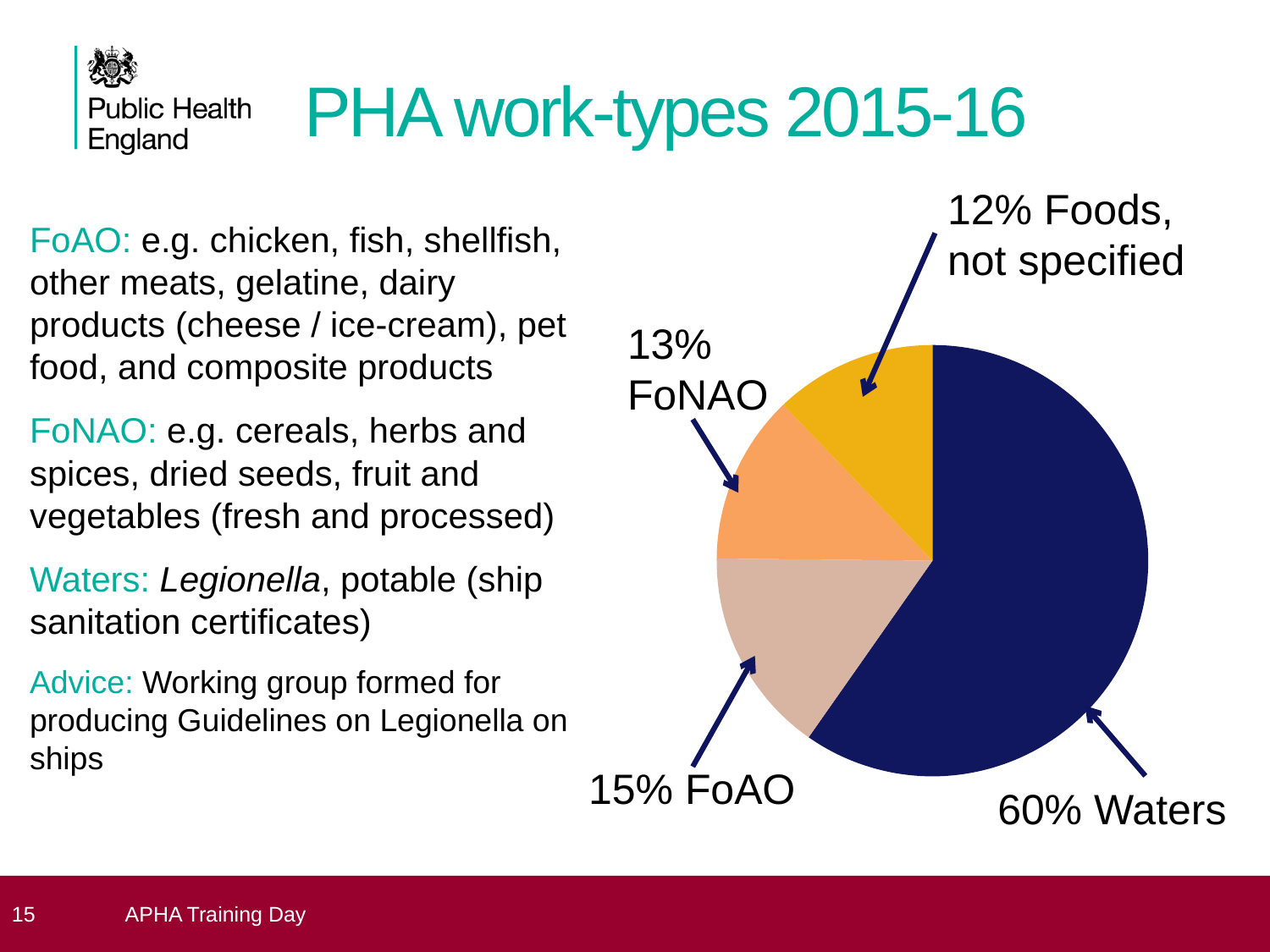
What share of the pie is FoAO? 15% Which work-type has the smallest share of the pie? Foods, not specified What share of the pie is Foods, not specified? 12% What share of the pie is FoNAO? 13% Which work-type has the largest share of the pie? Waters What kind of chart is shown on the slide? Pie chart What is the difference in percentage points between FoAO and FoNAO? 2 Which is larger, the share for FoNAO or the share for Foods, not specified? FoNAO How many slices does the pie chart have? 4 What is the title of the slide containing the chart? PHA work-types 2015-16 What is the difference in percentage points between Waters and FoAO? 45